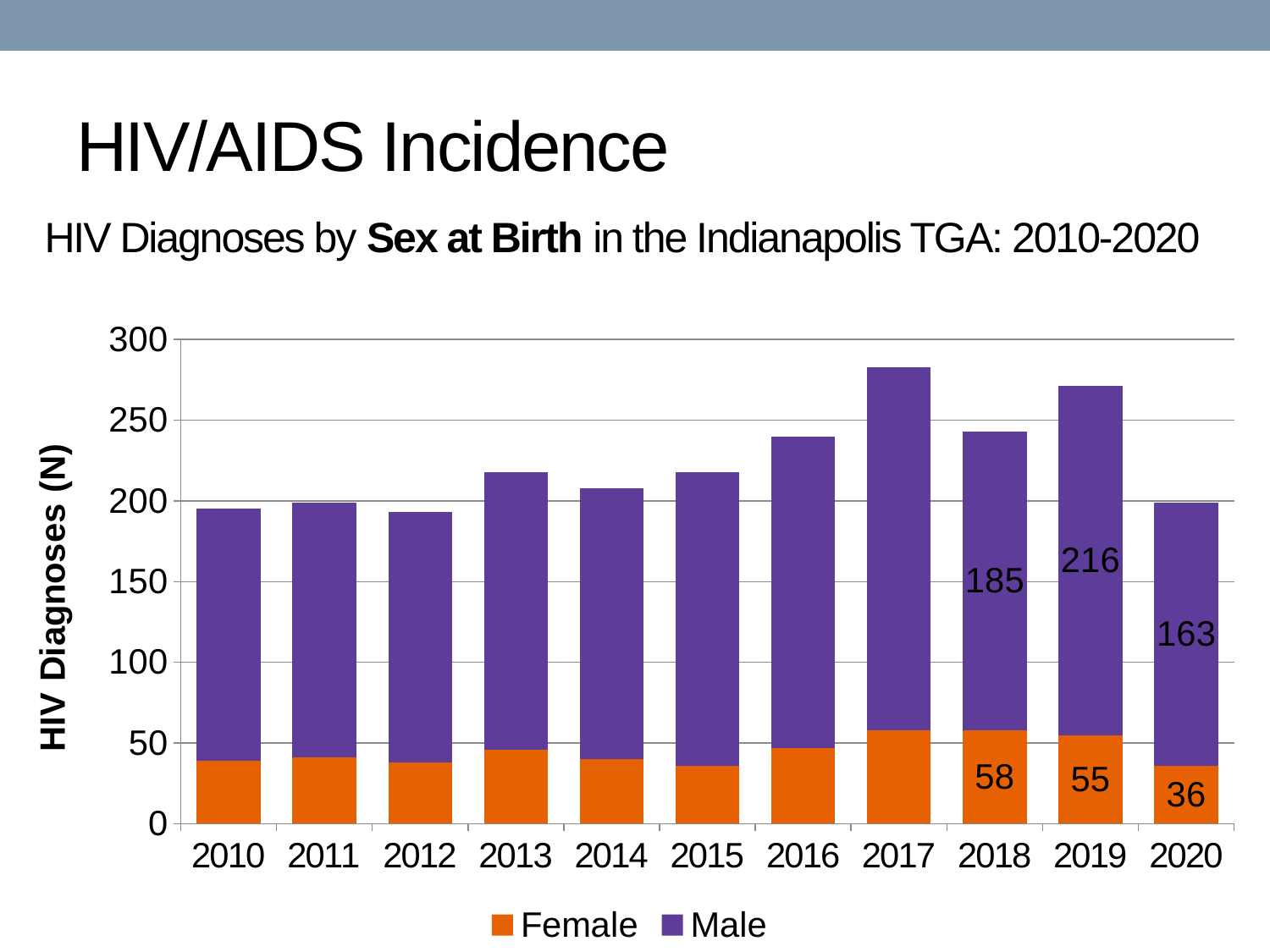
What is the total number of HIV diagnoses in 2020 (Female plus Male)? 199 Is the total value for 2017 greater or less than 250? greater What is the Male value for 2018? 185 What is the total number of HIV diagnoses in 2019 (Female plus Male)? 271 Which year has the highest total number of HIV diagnoses? 2017 What is the Male value for 2019? 216 What is the difference between the Male values for 2019 and 2018? 31 Is the total value for 2010 greater or less than 200? less What is the Female value for 2020? 36 Which is larger, the Female value for 2018 or the Female value for 2020? 2018 How many years are shown on the x axis? 11 How many series does the legend list? 2